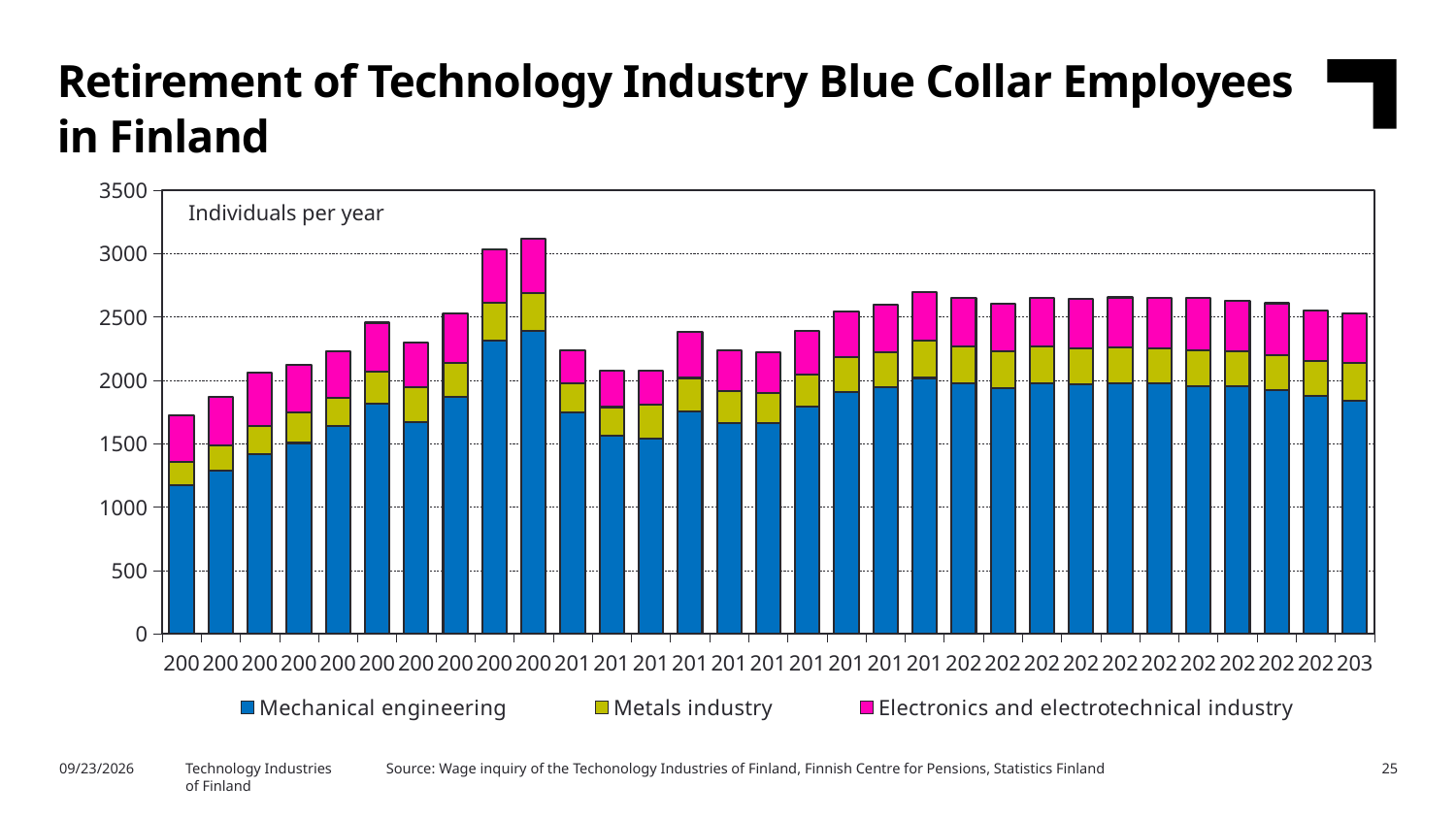
Is the Mechanical engineering segment of the tallest bar greater or less than 2000? greater Is the total of the tallest bar greater or less than 3000? greater Which series forms the largest segment in every bar? Mechanical engineering Do the bar totals generally rise or fall across the first ten bars from left to right? rise How many bars are plotted in the chart? 31 What are the three series named in the legend? Mechanical engineering, Metals industry, Electronics and electrotechnical industry How many series does the legend list? 3 Is the total of the last (rightmost) bar greater or less than 2000? greater What unit label is shown inside the plot area? Individuals per year What kind of chart is shown on the slide? Stacked bar chart Which series forms the smallest segment in the first (leftmost) bar? Metals industry